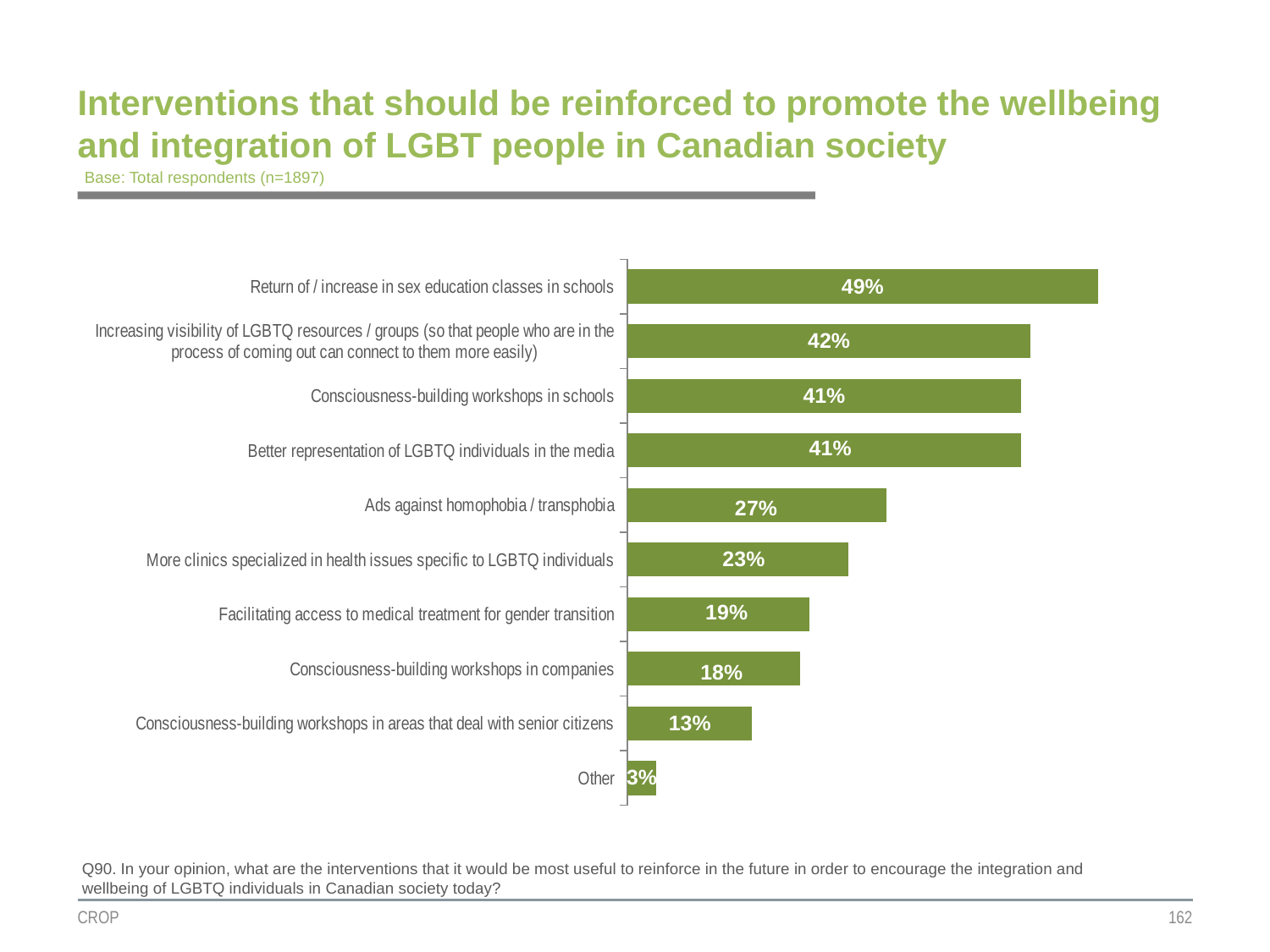
What colour are the bars in the chart? Green Which intervention has the highest percentage? Return of / increase in sex education classes in schools What is the difference between 'Return of / increase in sex education classes in schools' and 'Increasing visibility of LGBTQ resources / groups'? 7% What is the value for 'Ads against homophobia / transphobia'? 27% What is the difference between 'More clinics specialized in health issues specific to LGBTQ individuals' and 'Facilitating access to medical treatment for gender transition'? 4% How many categories are shown in the chart? 10 Which category has the lowest percentage? Other Which is larger: 'Ads against homophobia / transphobia' or 'Consciousness-building workshops in areas that deal with senior citizens'? Ads against homophobia / transphobia What is the base (number of respondents) stated for the chart? Total respondents (n=1897) What percentage of respondents chose 'Return of / increase in sex education classes in schools'? 49% What kind of chart is shown on the slide? Bar chart What is the value for 'Consciousness-building workshops in companies'? 18%